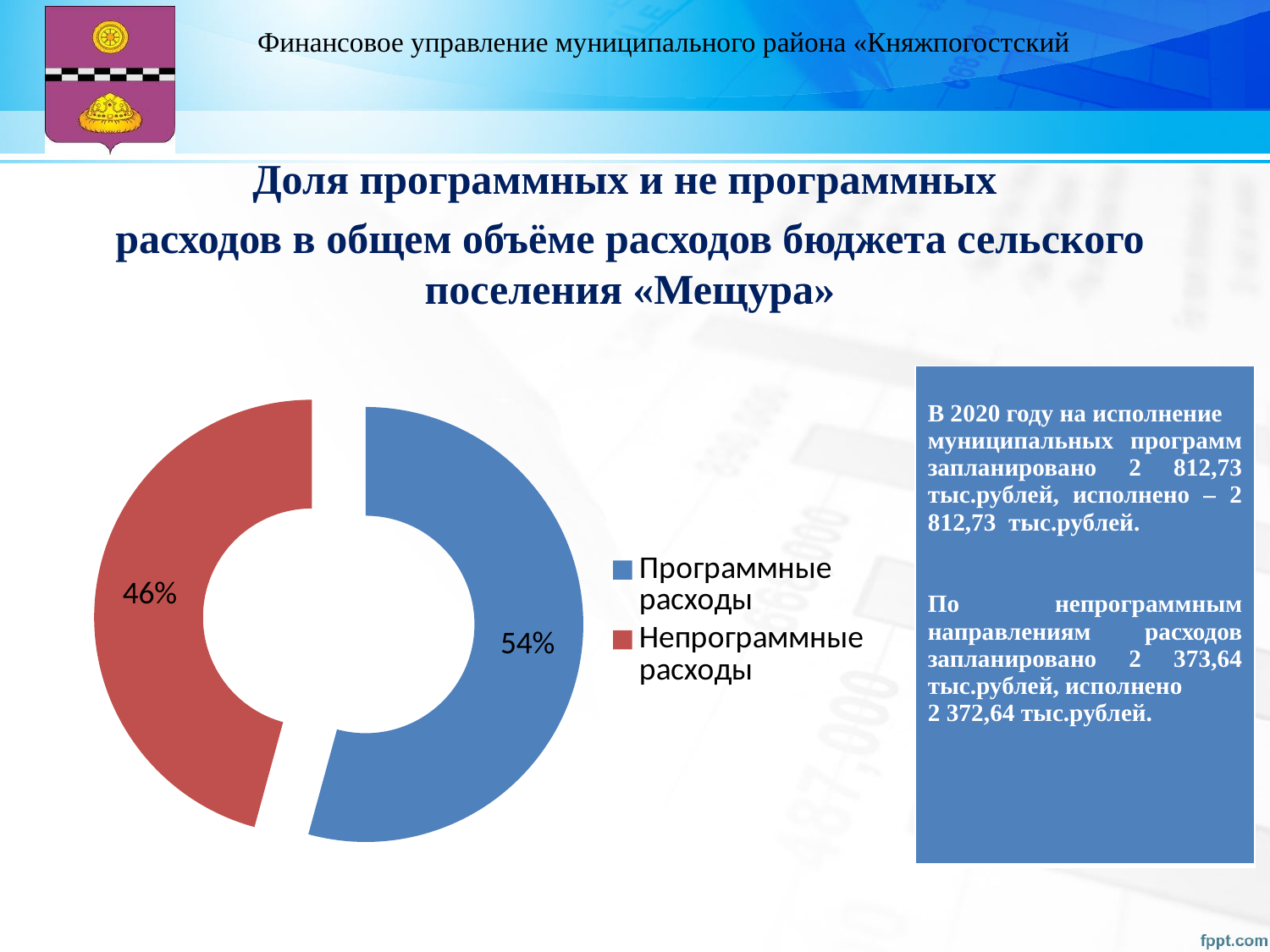
How many categories are shown in the chart? 2 What colour represents Программные расходы in the chart? blue By how many percentage points does the share of Программные расходы exceed that of Непрограммные расходы? 8 percentage points What share of the chart is labelled for Непрограммные расходы? 46% Is the share of Программные расходы larger or smaller than the share of Непрограммные расходы? larger What colour represents Непрограммные расходы in the chart? red How many entries does the legend list? 2 Which category has the smaller share of the chart? Непрограммные расходы What kind of chart is shown on the slide? doughnut (pie) chart Which category has the larger share of the chart? Программные расходы What share of the chart is labelled for Программные расходы? 54%